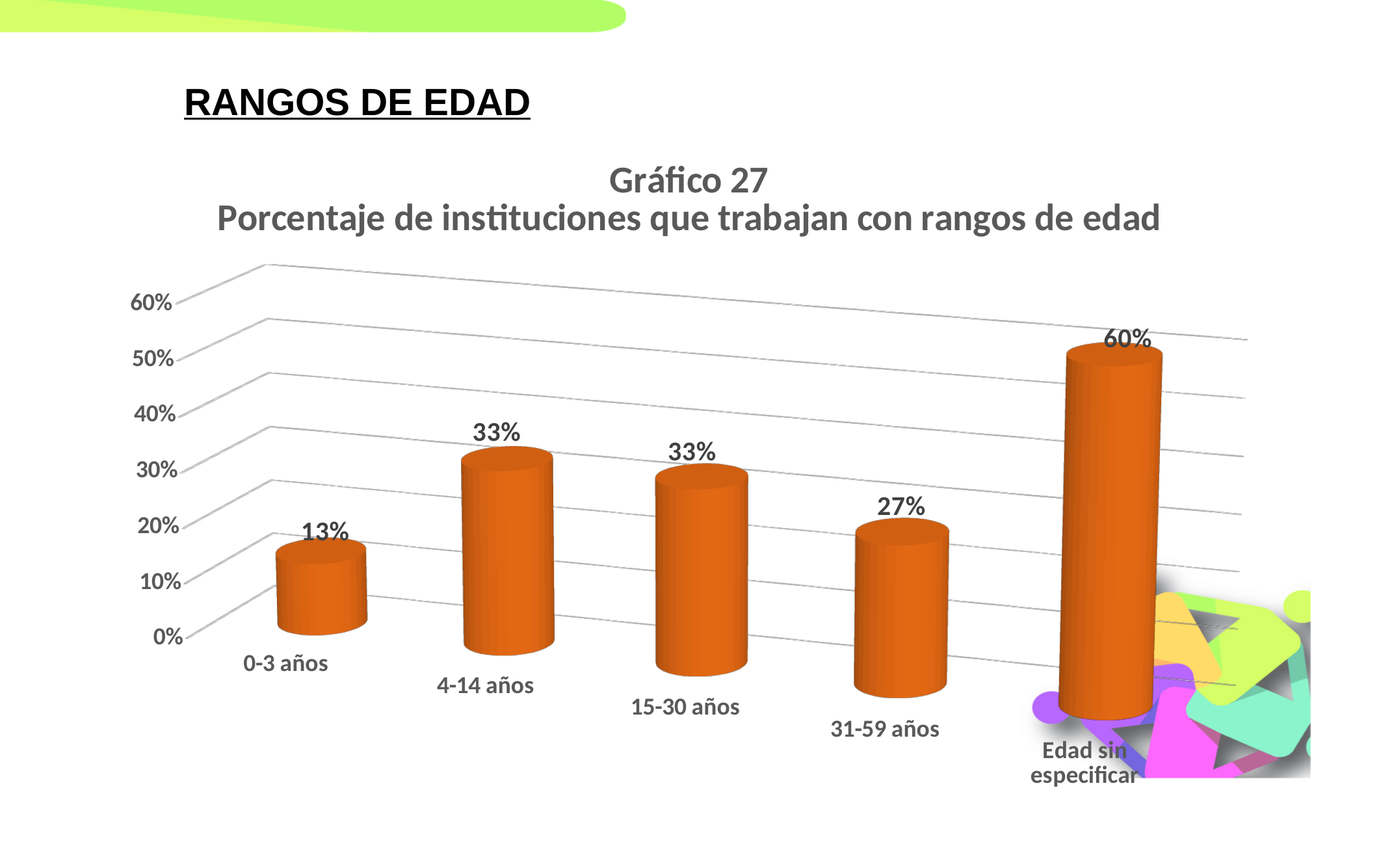
What kind of chart is shown on the slide? Bar chart What is the title of the chart? Gráfico 27 Porcentaje de instituciones que trabajan con rangos de edad What is the difference between the values for 4-14 años and 0-3 años? 20% How many categories are shown on the chart? 5 Which category has the lowest value? 0-3 años What is the value for Edad sin especificar? 60% What is the difference between the values for Edad sin especificar and 31-59 años? 33% What is the value for 0-3 años? 13% What is the value for 4-14 años? 33% Which is larger, the value for 15-30 años or the value for 31-59 años? 15-30 años Which category has the highest value? Edad sin especificar What is the value for 31-59 años? 27%